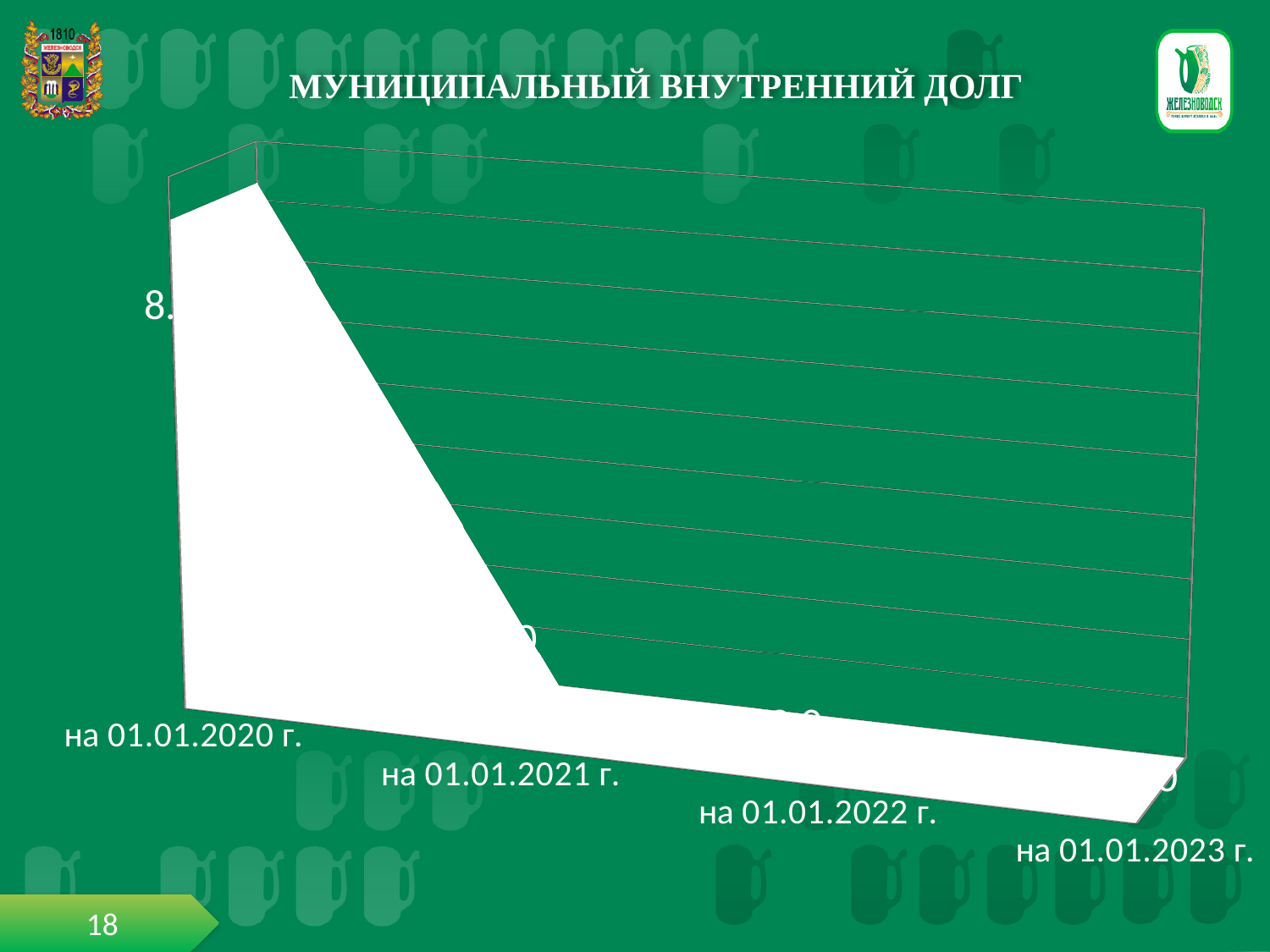
Which is larger, the value for 01.01.2020 or the value for 01.01.2023? на 01.01.2020 г. What kind of chart is shown on the slide? area chart What is the title of the chart on the slide? МУНИЦИПАЛЬНЫЙ ВНУТРЕННИЙ ДОЛГ Which date has the highest value in the chart? на 01.01.2020 г. Which is larger, the value for 01.01.2020 or the value for 01.01.2021? на 01.01.2020 г. How many dates (categories) are plotted along the x axis of the chart? 4 What is the label of the first category on the x axis of the chart? на 01.01.2020 г. Do the values in the chart rise or fall from 01.01.2020 to 01.01.2023? fall